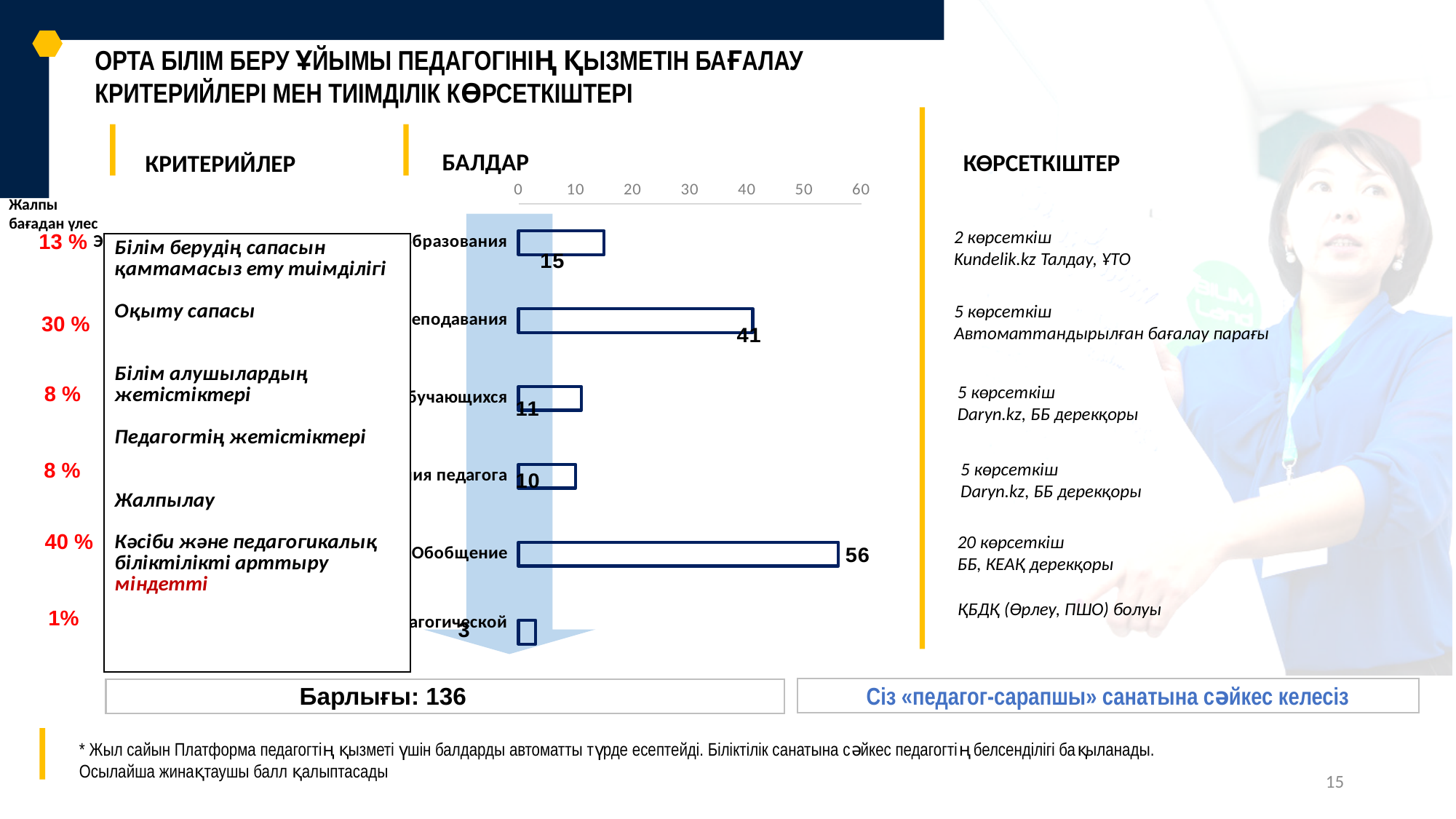
What is the value of the bar labelled Обобщение? 56 What kind of chart is shown on the slide? bar chart What is the value of the second bar from the top in the chart? 41 Which is larger: the third bar from the top (11) or the fourth bar from the top (10)? the third bar (11) What is the value of the last (bottom) bar in the chart? 3 Is the value of the Обобщение bar greater or less than 50? greater What is the lowest value shown in the chart? 3 Which bar has the highest value in the chart? Обобщение What is the difference between the Обобщение bar and the second bar from the top (41)? 15 How many bars does the chart have? 6 What is the maximum value shown on the chart's horizontal axis? 60 What is the value of the first (topmost) bar in the chart? 15